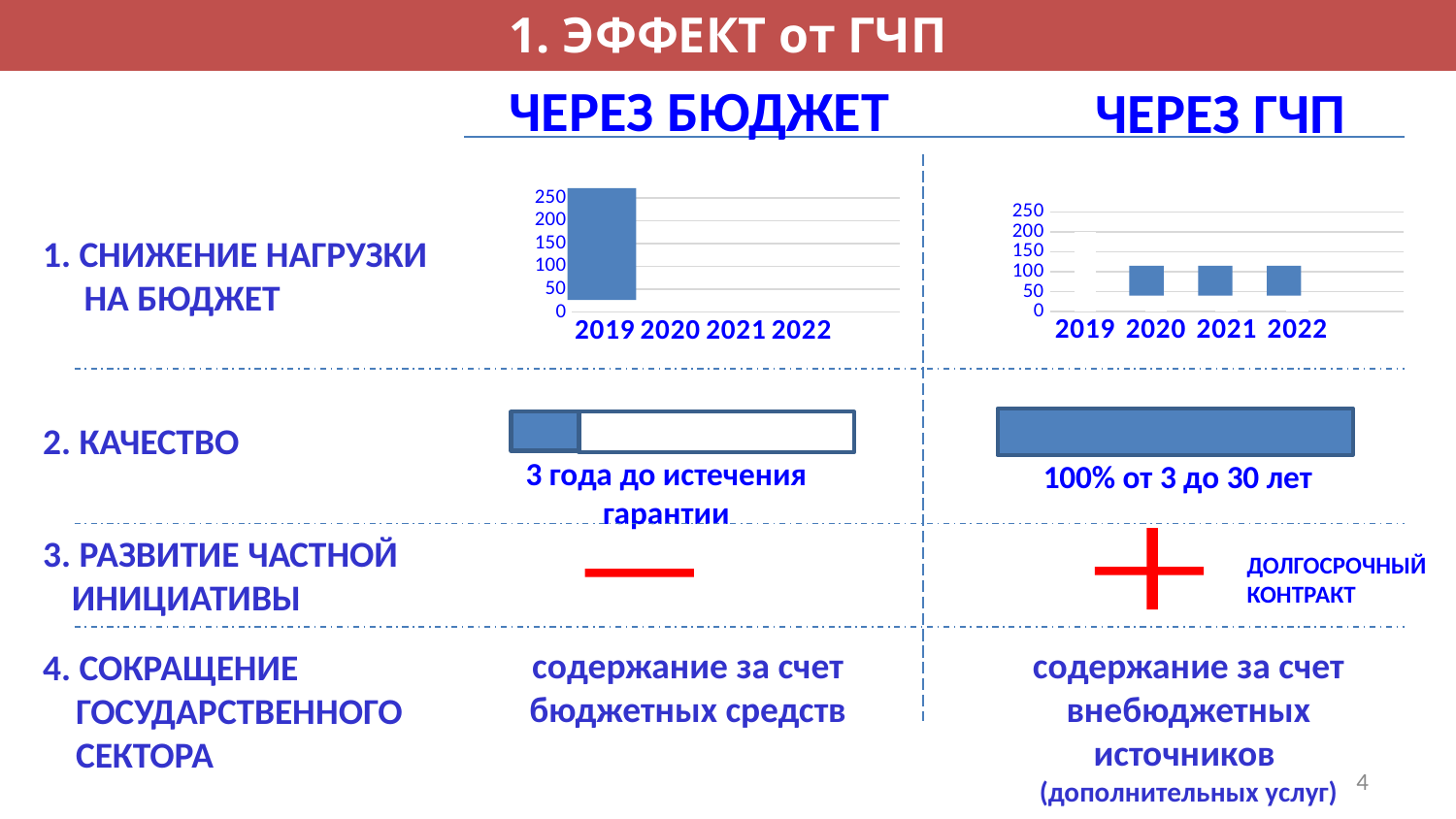
In the ЧЕРЕЗ ГЧП chart, do the bars for 2020, 2021 and 2022 rise, fall, or stay roughly level? stay roughly level In the ЧЕРЕЗ БЮДЖЕТ chart, is the value for 2019 greater or less than 200? greater In the ЧЕРЕЗ ГЧП chart, is the value for 2020 greater or less than 150? less What kind of chart is shown under the heading ЧЕРЕЗ БЮДЖЕТ? bar chart In the ЧЕРЕЗ БЮДЖЕТ chart, how many years are listed on the x axis? 4 In the ЧЕРЕЗ ГЧП chart, which year has the lowest value (no visible bar)? 2019 In the ЧЕРЕЗ ГЧП chart, how many years are listed on the x axis? 4 In the ЧЕРЕЗ БЮДЖЕТ chart, which year has the highest bar? 2019 What kind of chart is shown under the heading ЧЕРЕЗ ГЧП? bar chart In the ЧЕРЕЗ ГЧП chart, is the value for 2022 greater or less than 50? greater Which is larger: the 2019 bar in the ЧЕРЕЗ БЮДЖЕТ chart or the 2020 bar in the ЧЕРЕЗ ГЧП chart? 2019 bar in the ЧЕРЕЗ БЮДЖЕТ chart What is the highest tick value shown on the vertical axis of the ЧЕРЕЗ БЮДЖЕТ chart? 250